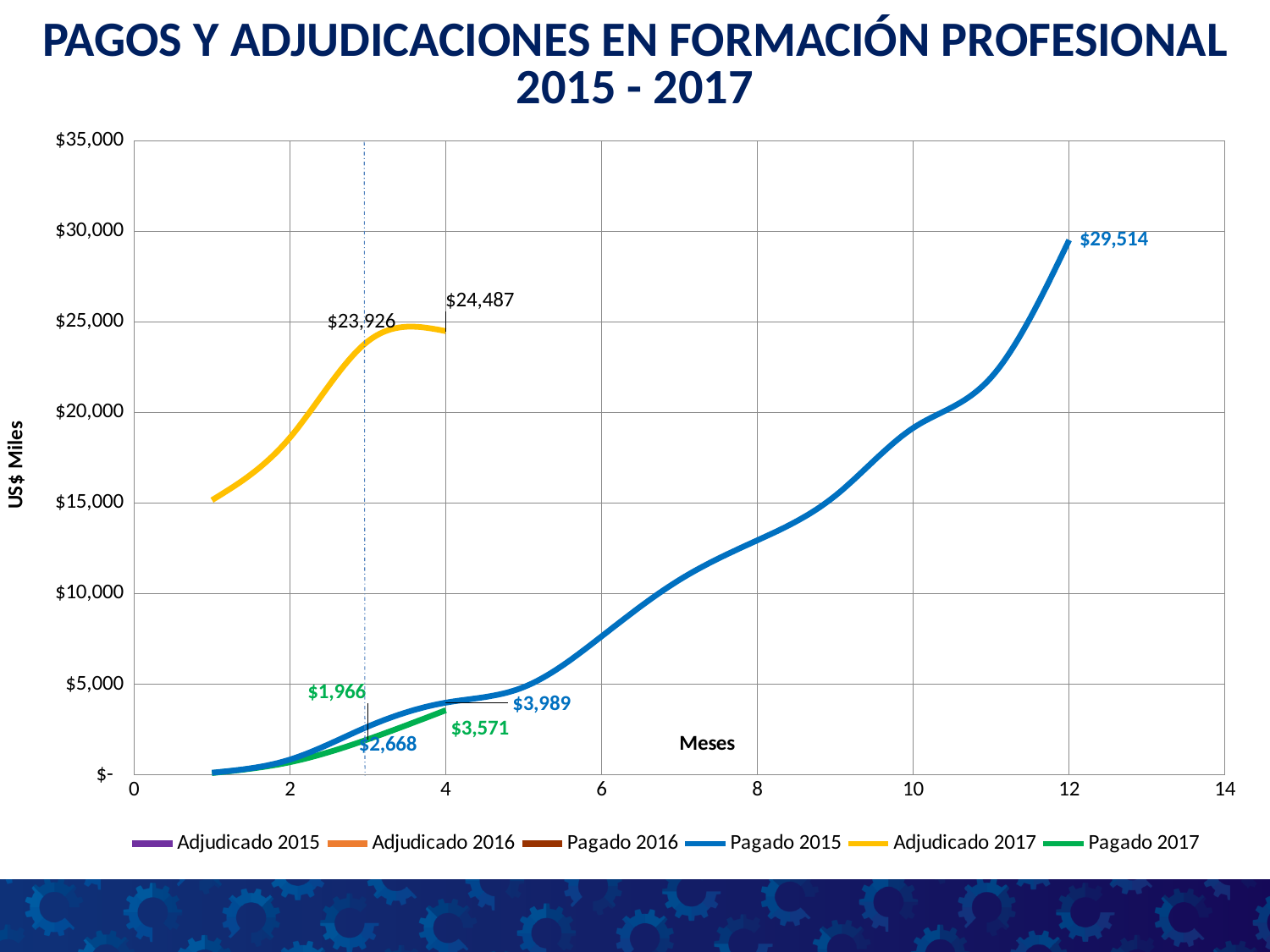
What is the value of Adjudicado 2017 at month 3? $23,926 What is the difference between Pagado 2015 and Pagado 2017 at month 4? $418 Is the value of Pagado 2015 at month 8 greater or less than $10,000? greater What is the value of Adjudicado 2017 at month 4? $24,487 At month 3, which is larger: Pagado 2015 or Pagado 2017? Pagado 2015 What is the value of Pagado 2015 at month 12? $29,514 What kind of chart is shown on the slide? line chart What is the value of Pagado 2017 at month 3? $1,966 What is the title of the vertical axis? US$ Miles How many series does the legend list? 6 By how much did Adjudicado 2017 increase from month 3 to month 4? $561 Does the Pagado 2015 line rise or fall as the months increase? rise